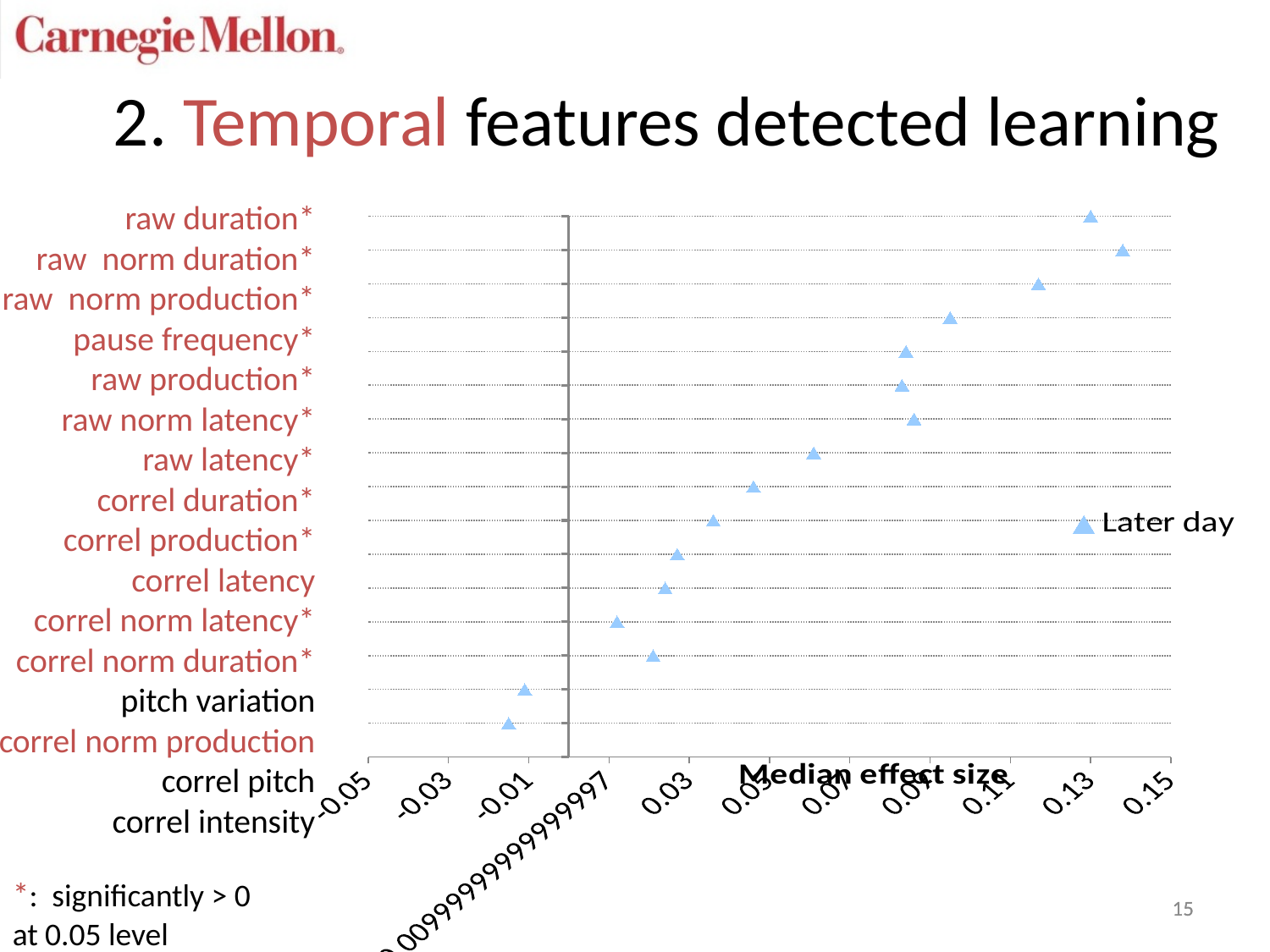
Is the value for the bottommost point greater or less than 0.01? less What is the name of the series shown in the legend? Later day Moving from the bottom of the chart to the top, do the plotted median effect sizes generally rise or fall? rise Is the value for the rightmost point greater or less than 0.11? greater How many data points are plotted in the chart? 16 Is the value for the leftmost point greater or less than 0.01? less What kind of chart is shown on the slide? scatter chart How many series does the legend list? 1 What is the title of the horizontal axis? Median effect size Are most of the plotted median effect sizes positive or negative? positive How many data points lie to the left of the zero line (negative median effect size)? 2